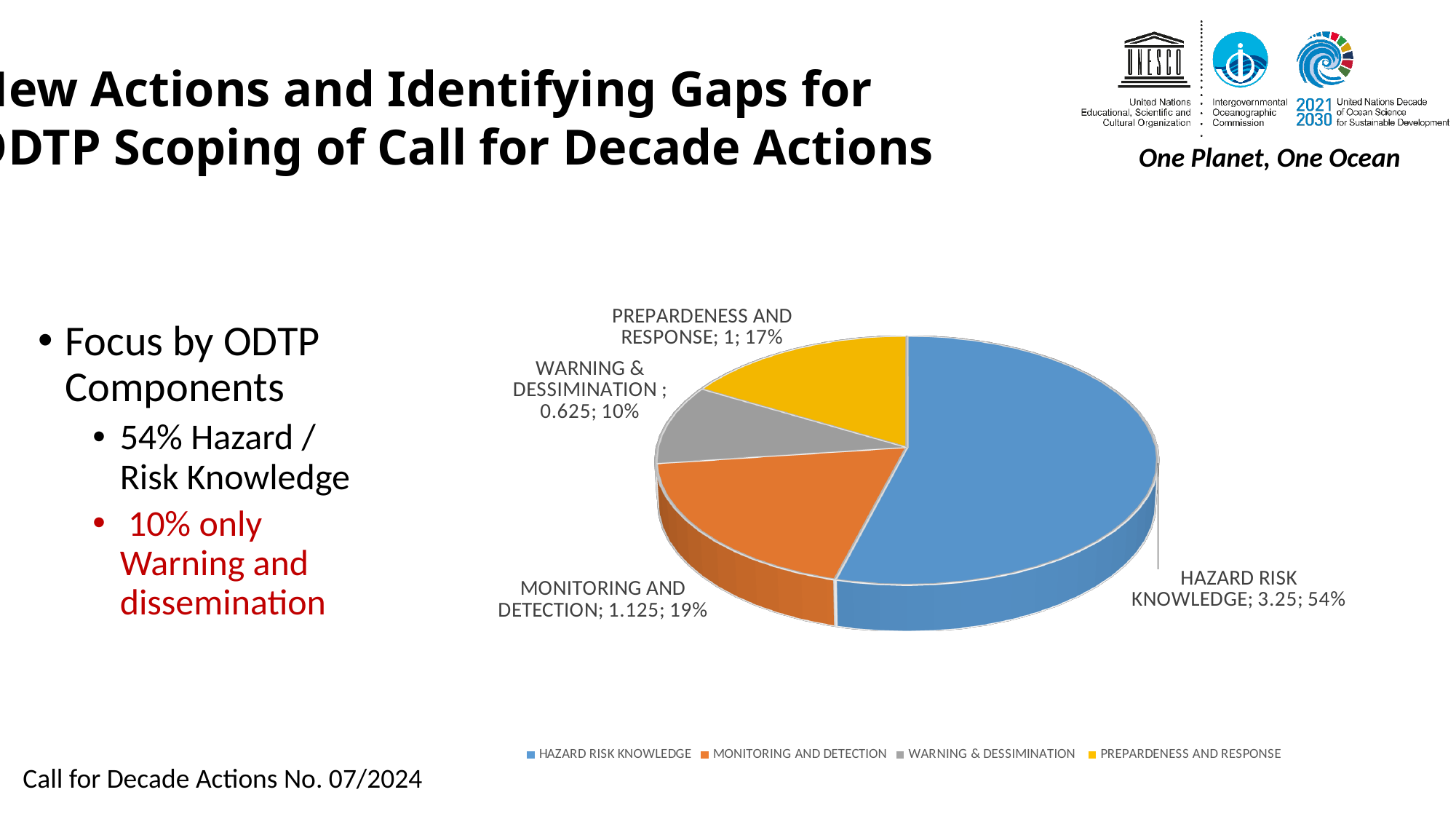
What colour is the HAZARD RISK KNOWLEDGE slice in the pie chart? Blue What percentage share does PREPARDENESS AND RESPONSE have in the pie chart? 17% Which category has the largest slice in the pie chart? HAZARD RISK KNOWLEDGE What kind of chart is shown on the slide? Pie chart Which is larger in the pie chart, MONITORING AND DETECTION or PREPARDENESS AND RESPONSE? MONITORING AND DETECTION What value is shown for HAZARD RISK KNOWLEDGE in the pie chart? 3.25 How many slices does the pie chart have? 4 Which category has the smallest slice in the pie chart? WARNING & DESSIMINATION What value is shown for WARNING & DESSIMINATION in the pie chart? 0.625 How many entries does the pie chart's legend list? 4 What percentage share does MONITORING AND DETECTION have in the pie chart? 19% What is the difference between the values for HAZARD RISK KNOWLEDGE and MONITORING AND DETECTION? 2.125